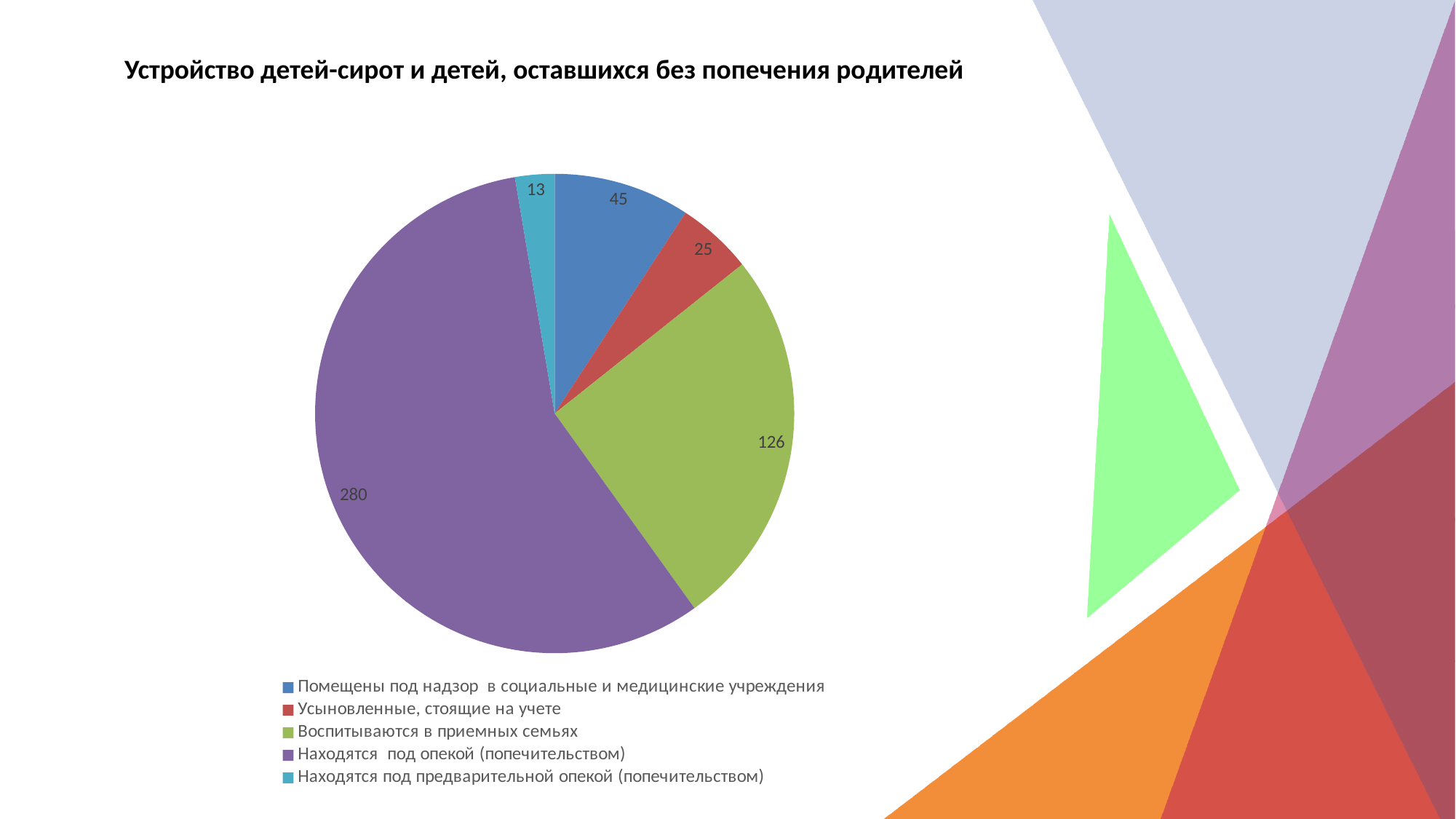
What is the value for 'Находятся под предварительной опекой (попечительством)'? 13 What is the title of the chart? Устройство детей-сирот и детей, оставшихся без попечения родителей What is the difference between the values for 'Находятся под опекой (попечительством)' and 'Воспитываются в приемных семьях'? 154 What is the value for 'Находятся под опекой (попечительством)'? 280 What type of chart is shown on the slide? pie chart Which category has the smallest slice? Находятся под предварительной опекой (попечительством) How many slices does the pie chart have? 5 What is the value for 'Усыновленные, стоящие на учете'? 25 Which is larger: the value for 'Помещены под надзор в социальные и медицинские учреждения' or for 'Усыновленные, стоящие на учете'? Помещены под надзор в социальные и медицинские учреждения What is the value for 'Воспитываются в приемных семьях'? 126 Which category has the largest slice? Находятся под опекой (попечительством) How many entries does the legend list? 5